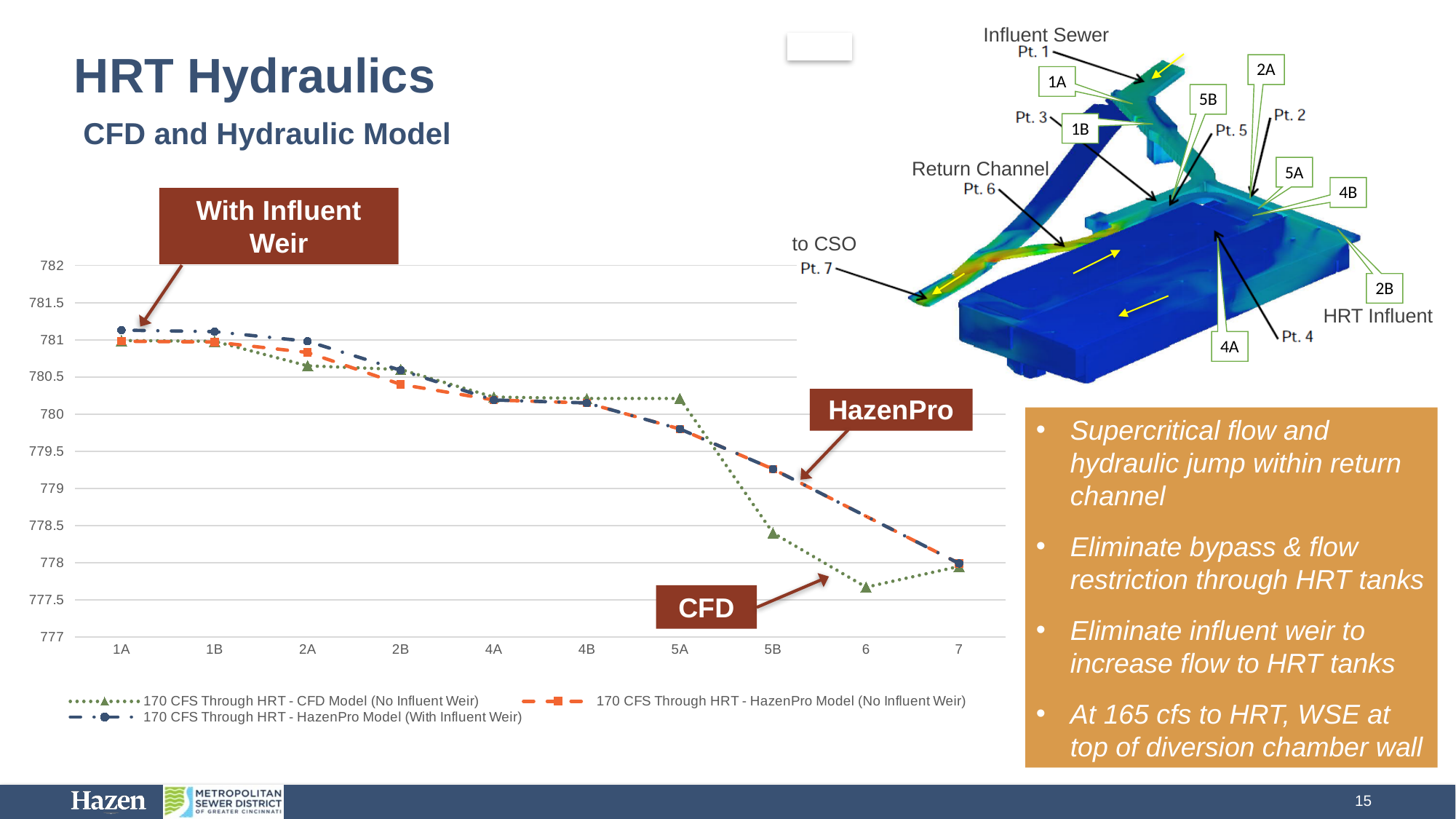
At point 5A, which series has the larger value: the CFD Model (No Influent Weir) or the HazenPro Model (No Influent Weir)? CFD Model (No Influent Weir) How many series does the chart legend list? 3 Is the value for the HazenPro Model (No Influent Weir) series at point 5B greater or less than 779? greater At which x-axis point does the CFD Model (No Influent Weir) series reach its lowest value? 6 How many categories are shown along the x axis of the chart? 10 Is the value for the HazenPro Model (With Influent Weir) series at point 1A greater or less than 781? greater What kind of chart is shown on the slide? line chart Is the value for the CFD Model (No Influent Weir) series at point 6 greater or less than 778? less At point 6, which series has the larger value: the CFD Model (No Influent Weir) or the HazenPro Model (No Influent Weir)? HazenPro Model (No Influent Weir) Do the plotted values generally rise or fall from 1A to 7 along the x axis? fall Which series in the legend is drawn with a dotted green line and triangle markers? 170 CFS Through HRT - CFD Model (No Influent Weir)